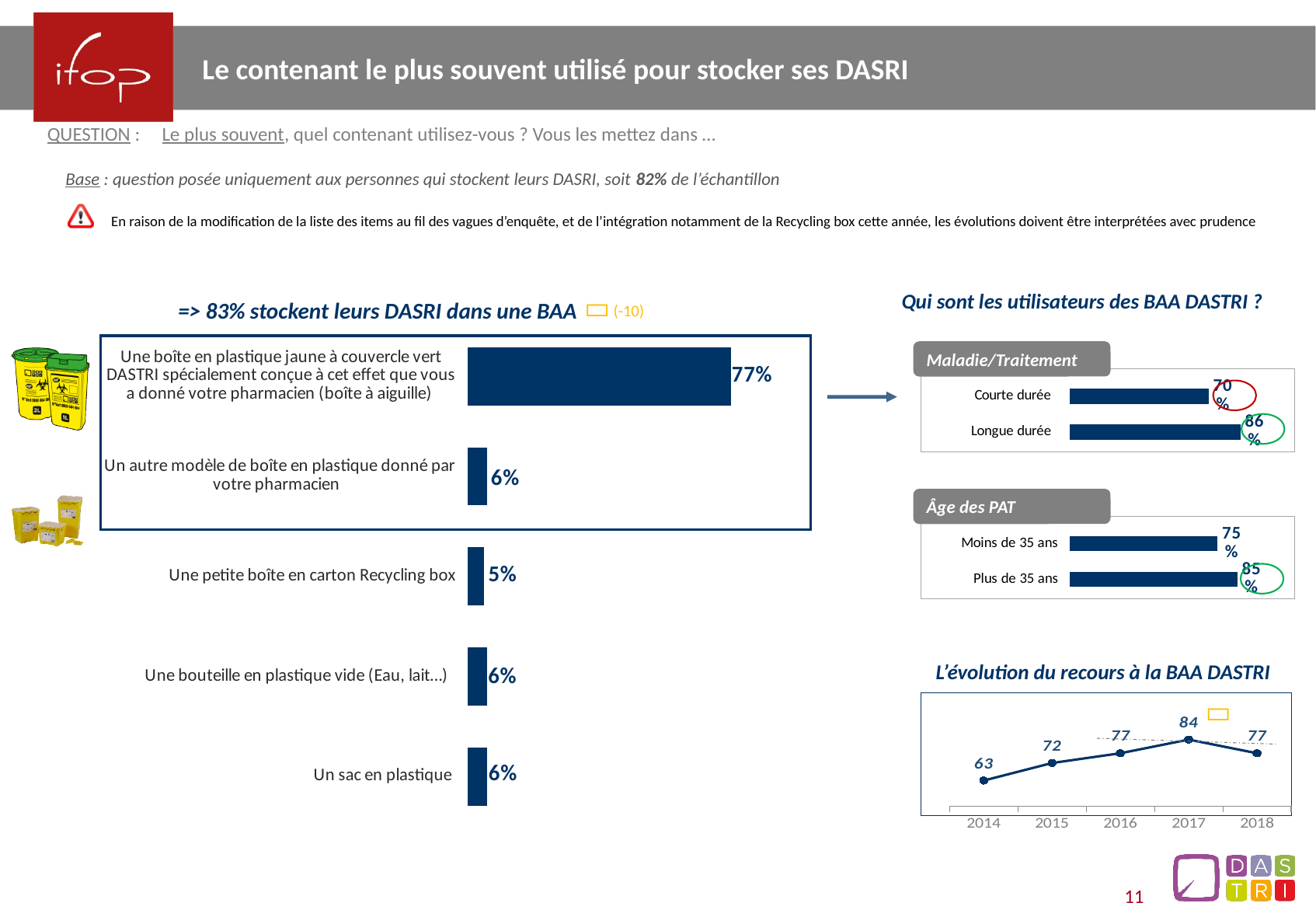
In the chart 'L'évolution du recours à la BAA DASTRI', which year has the lowest value? 2014 In the main bar chart on the left, what is the value for 'Une petite boîte en carton Recycling box'? 5% In the 'Maladie/Traitement' chart, which is larger, 'Courte durée' or 'Longue durée'? Longue durée In the main bar chart on the left, what is the difference between the value for the DASTRI boîte à aiguille and the value for 'Un sac en plastique'? 71% What kind of chart is 'L'évolution du recours à la BAA DASTRI'? Line chart In the main bar chart on the left, how many categories are shown? 5 In the main bar chart on the left, which category has the highest value? Une boîte en plastique jaune à couvercle vert DASTRI spécialement conçue à cet effet que vous a donné votre pharmacien (boîte à aiguille) In the 'Maladie/Traitement' chart, what is the value for 'Longue durée'? 86% In the main bar chart on the left, which category has the lowest value? Une petite boîte en carton Recycling box In the main bar chart on the left, what is the value for 'Une boîte en plastique jaune à couvercle vert DASTRI spécialement conçue à cet effet que vous a donné votre pharmacien (boîte à aiguille)'? 77% In the 'Âge des PAT' chart, what is the difference between 'Plus de 35 ans' and 'Moins de 35 ans'? 10% In the chart 'L'évolution du recours à la BAA DASTRI', what is the value for 2017? 84